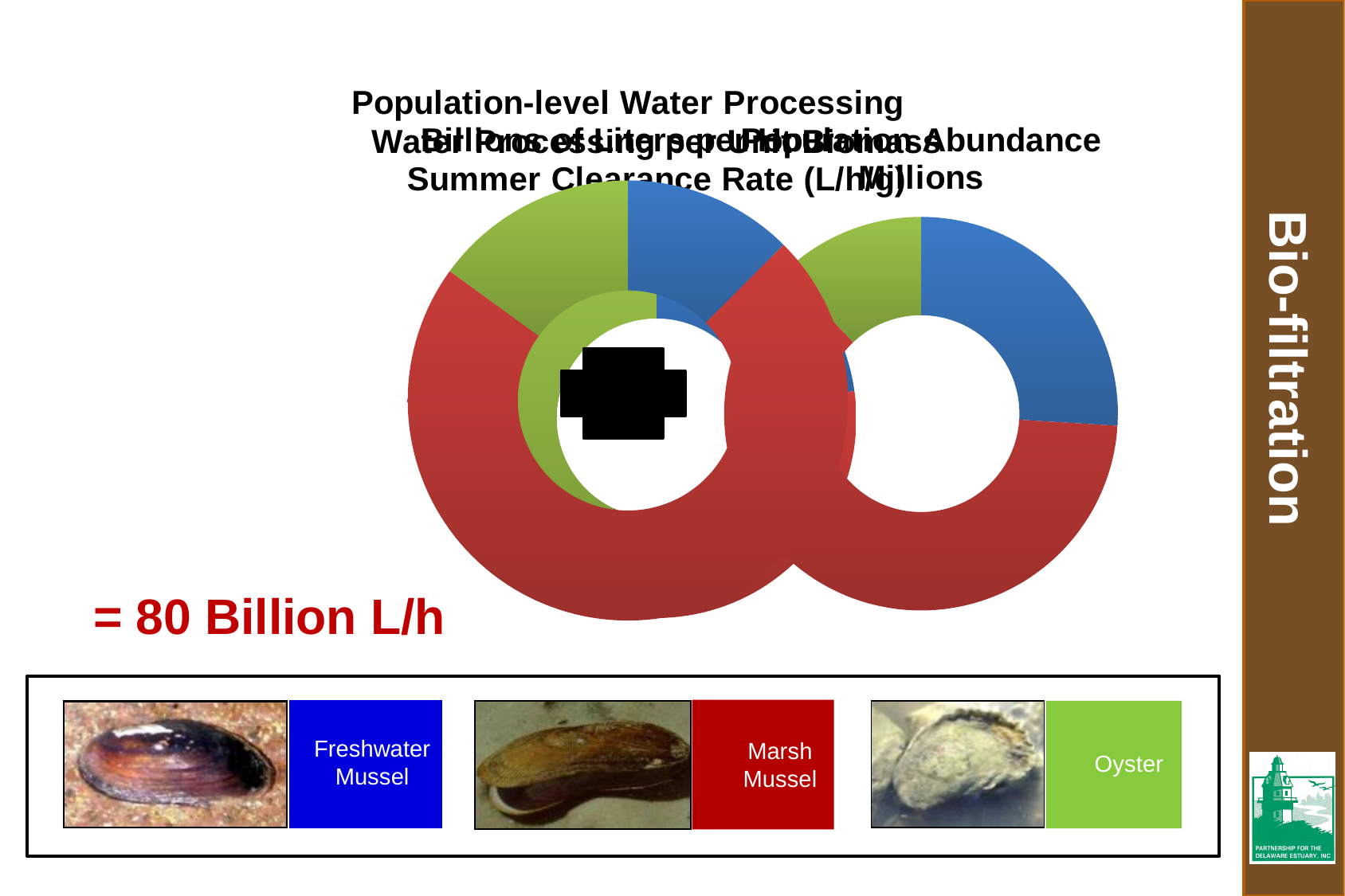
What total water processing figure is stated in red text on the slide? = 80 Billion L/h How many species are listed in the legend at the bottom of the slide? 3 What kind of chart is used on this slide? doughnut chart In the rightmost doughnut chart, which species has the largest slice? Marsh Mussel In the rightmost doughnut chart, which species has the smallest slice? Oyster In the large leftmost doughnut chart, which slice is larger: Marsh Mussel or Freshwater Mussel? Marsh Mussel In the rightmost doughnut chart, which slice is larger: Freshwater Mussel or Oyster? Freshwater Mussel In the large leftmost doughnut chart, which species has the largest slice? Marsh Mussel Which colour represents Oyster in the charts? green